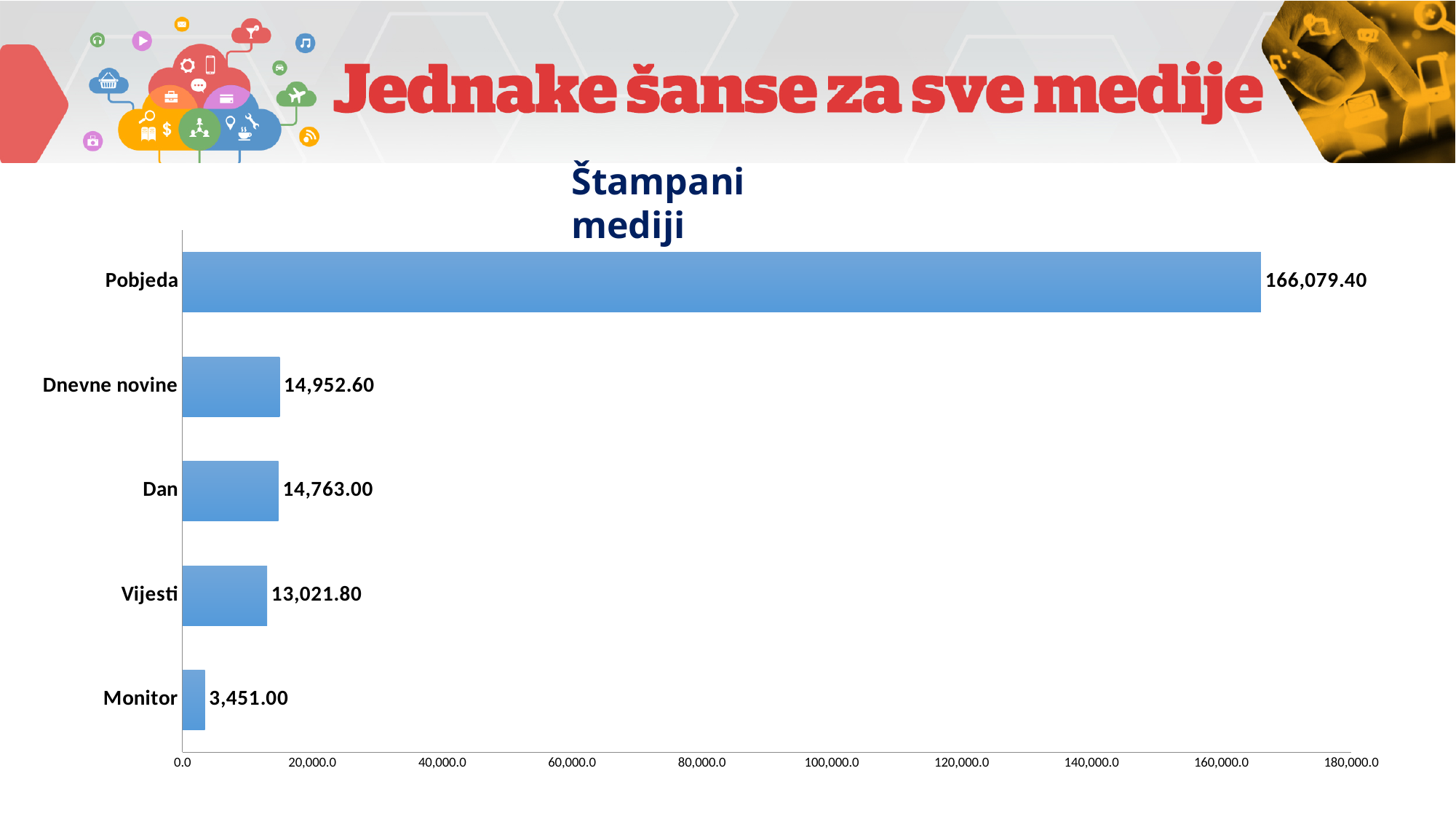
Which category has the lowest value? Monitor What is the title of the chart? Štampani mediji What is the difference between the values for Pobjeda and Dnevne novine? 151,126.80 What is the value for Monitor? 3,451.00 Which has a larger value, Dan or Vijesti? Dan What is the value for Vijesti? 13,021.80 How many categories are shown in the chart? 5 What is the difference between the values for Vijesti and Monitor? 9,570.80 What is the value for Pobjeda? 166,079.40 Which category has the highest value? Pobjeda What is the value for Dan? 14,763.00 What is the value for Dnevne novine? 14,952.60